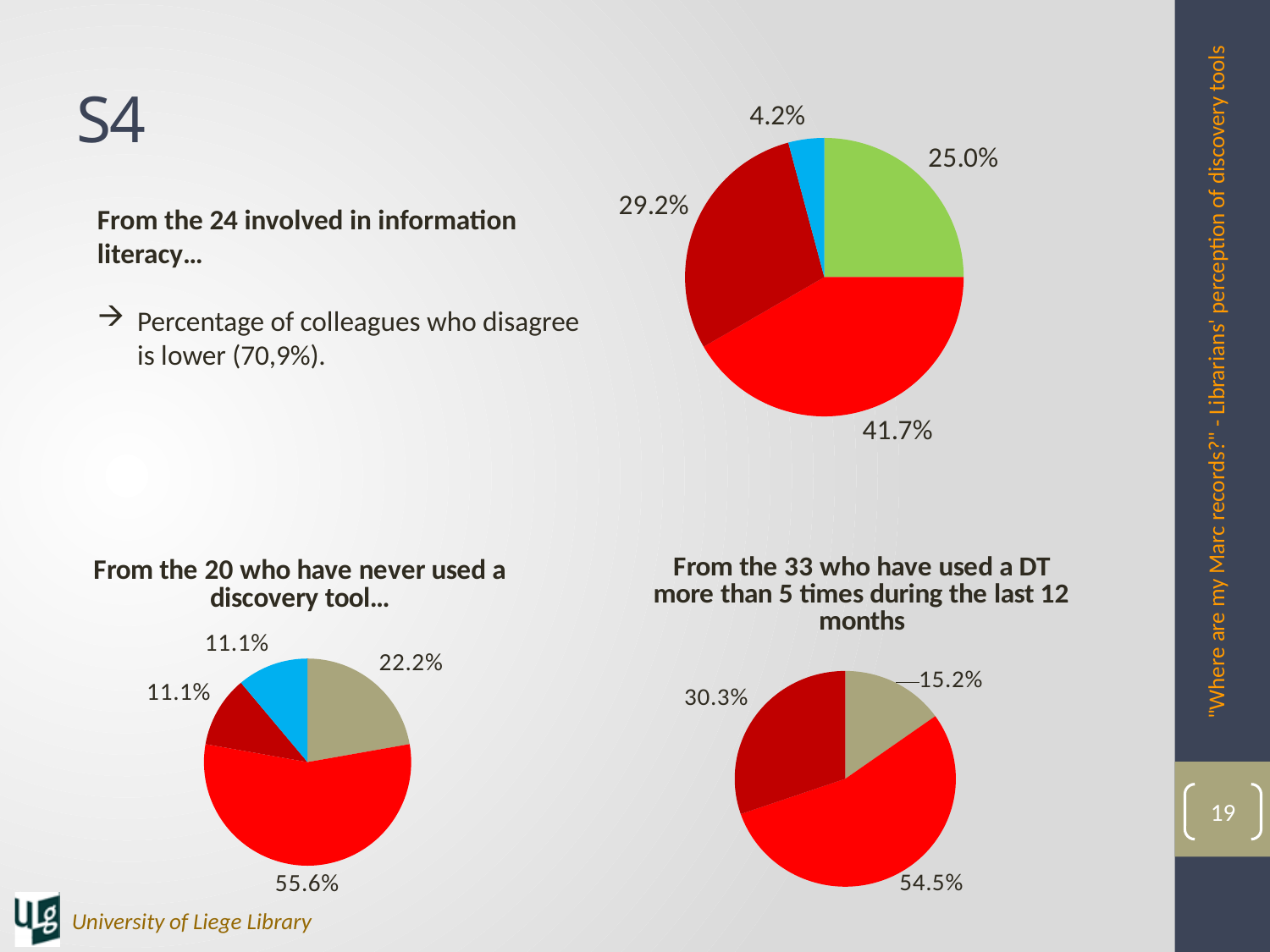
In the top-right pie chart, how many slices are there? 4 In the chart titled 'From the 33 who have used a DT more than 5 times during the last 12 months', which is larger, the 30.3% slice or the 54.5% slice? 54.5% In the chart titled 'From the 33 who have used a DT more than 5 times during the last 12 months', how many slices are there? 3 In the chart titled 'From the 20 who have never used a discovery tool…', what is the difference between the 55.6% slice and the 22.2% slice? 33.4% In the top-right pie chart, what is the value of the largest slice? 41.7% In the top-right pie chart, what is the value of the smallest slice? 4.2% In the chart titled 'From the 20 who have never used a discovery tool…', how many slices are there? 4 In the top-right pie chart, what colour is the 25.0% slice? green In the chart titled 'From the 20 who have never used a discovery tool…', what is the value of the largest slice? 55.6% In the top-right pie chart, what is the difference between the largest slice (41.7%) and the 29.2% slice? 12.5% What type of chart is used in the top-right chart on the slide? pie chart In the chart titled 'From the 33 who have used a DT more than 5 times during the last 12 months', what is the value of the smallest slice? 15.2%